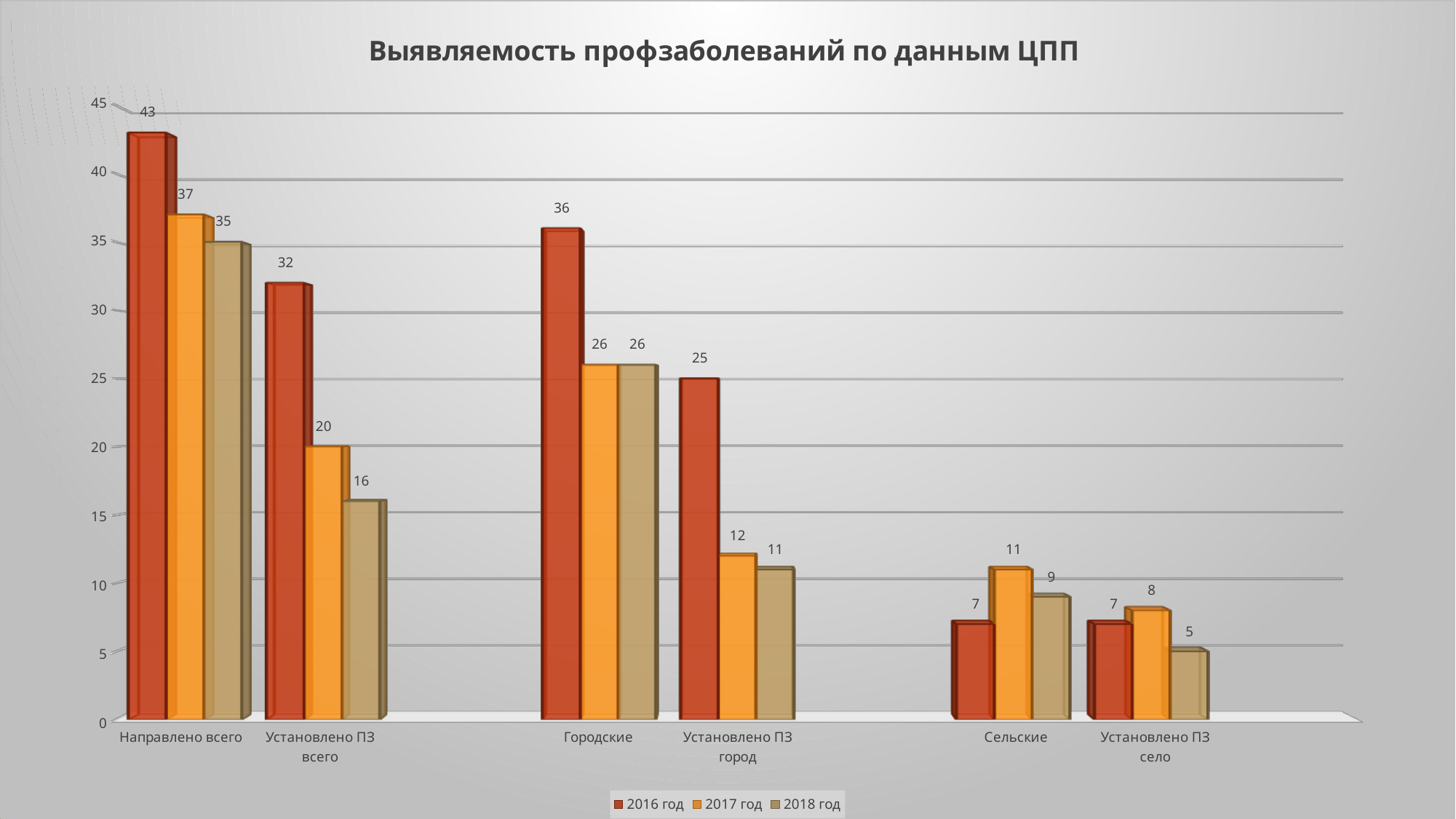
What kind of chart is shown on the slide? bar chart How many series does the legend list? 3 What is the value for 2017 год in the Сельские category? 11 Which category has the lowest value for 2018 год? Установлено ПЗ село What is the value for 2018 год in the Установлено ПЗ всего category? 16 Is the value for 2017 год in the Установлено ПЗ город category greater or less than 15? less Which is larger in the Сельские category: the value for 2016 год or for 2018 год? 2018 год How many categories are shown on the x axis? 6 Which category has the highest value for 2016 год? Направлено всего What is the difference between the 2016 год and 2017 год values in the Городские category? 10 What is the value for 2016 год in the Направлено всего category? 43 What is the title of the chart? Выявляемость профзаболеваний по данным ЦПП